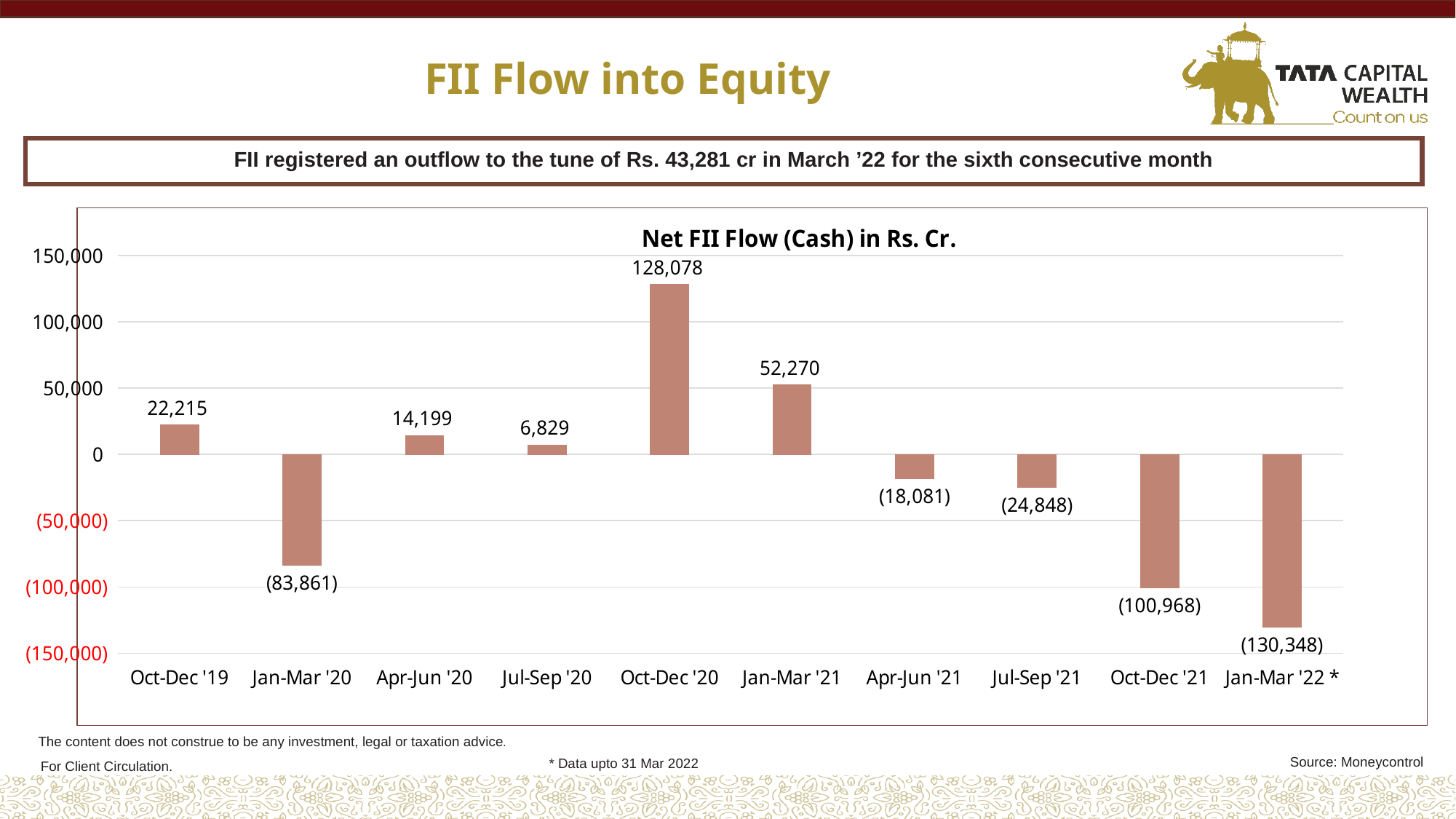
Which period has the highest Net FII Flow (Cash)? Oct-Dec '20 What is the Net FII Flow (Cash) value for Jul-Sep '20? 6,829 How many periods are shown on the x axis of the Net FII Flow (Cash) chart? 10 What is the difference between the Net FII Flow values for Oct-Dec '20 and Jan-Mar '21? 75,808 Which period has a larger Net FII Flow (Cash): Oct-Dec '19 or Apr-Jun '20? Oct-Dec '19 What is the Net FII Flow (Cash) value for Oct-Dec '20? 128,078 What is the Net FII Flow (Cash) value for Oct-Dec '21? (100,968) What kind of chart is used to show Net FII Flow (Cash) in Rs. Cr.? Bar chart What is the title of the chart on the slide? Net FII Flow (Cash) in Rs. Cr. What is the Net FII Flow (Cash) value for Jan-Mar '22 *? (130,348) Which period has the lowest Net FII Flow (Cash)? Jan-Mar '22 * Is the Net FII Flow (Cash) value for Jan-Mar '20 greater or less than (50,000)? less